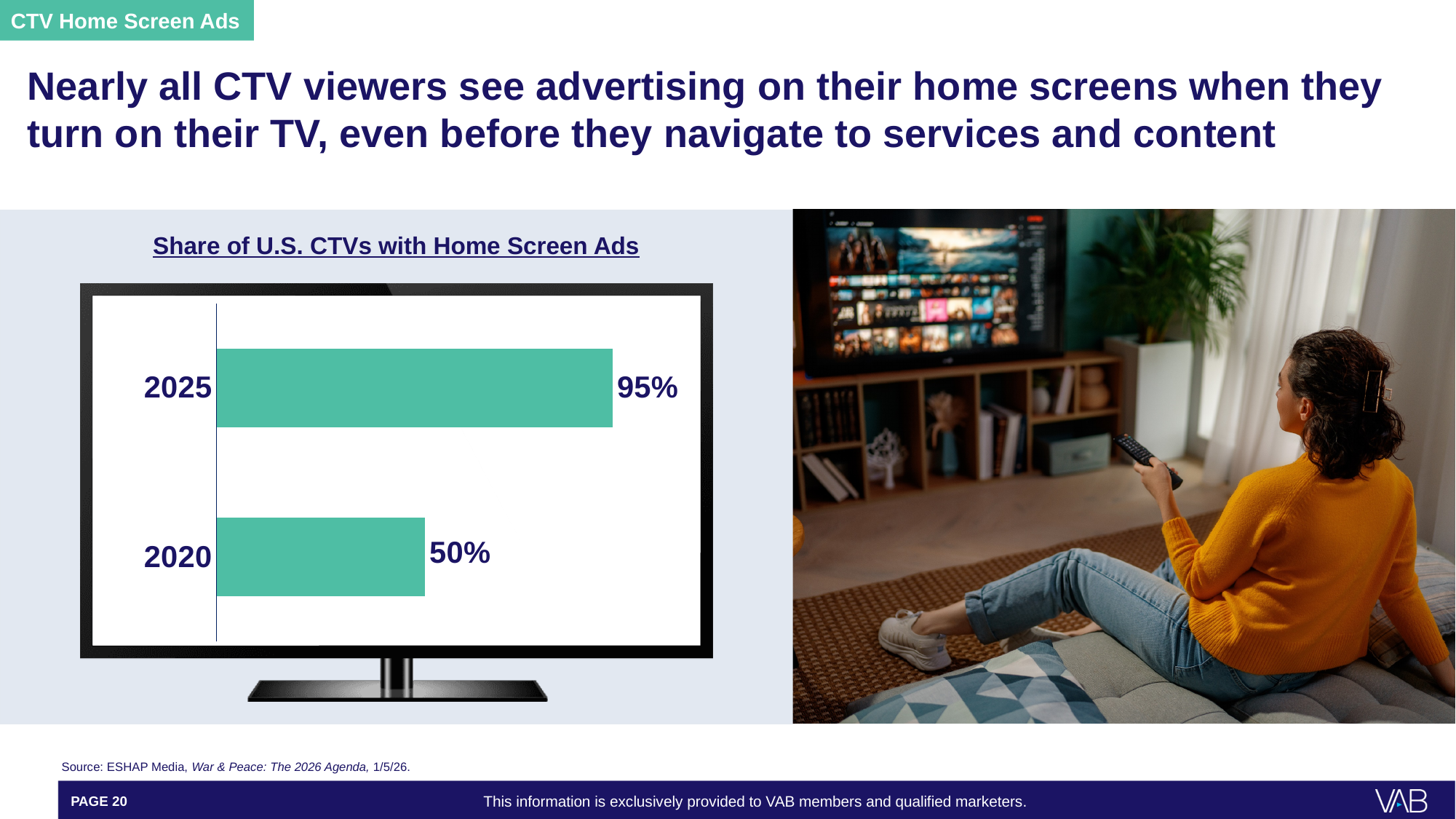
What is the title of the chart? Share of U.S. CTVs with Home Screen Ads What kind of chart is used to show the share of U.S. CTVs with home screen ads? Bar chart Which year has the lower share of U.S. CTVs with home screen ads? 2020 Is the share of U.S. CTVs with home screen ads larger in 2020 or in 2025? 2025 What is the share of U.S. CTVs with home screen ads in 2025? 95% Which year has the higher share of U.S. CTVs with home screen ads? 2025 What colour are the bars in the chart? Teal/green By how many percentage points did the share of U.S. CTVs with home screen ads increase from 2020 to 2025? 45 percentage points How many years are shown in the chart? 2 Did the share of U.S. CTVs with home screen ads rise or fall between 2020 and 2025? Rise What is the share of U.S. CTVs with home screen ads in 2020? 50%